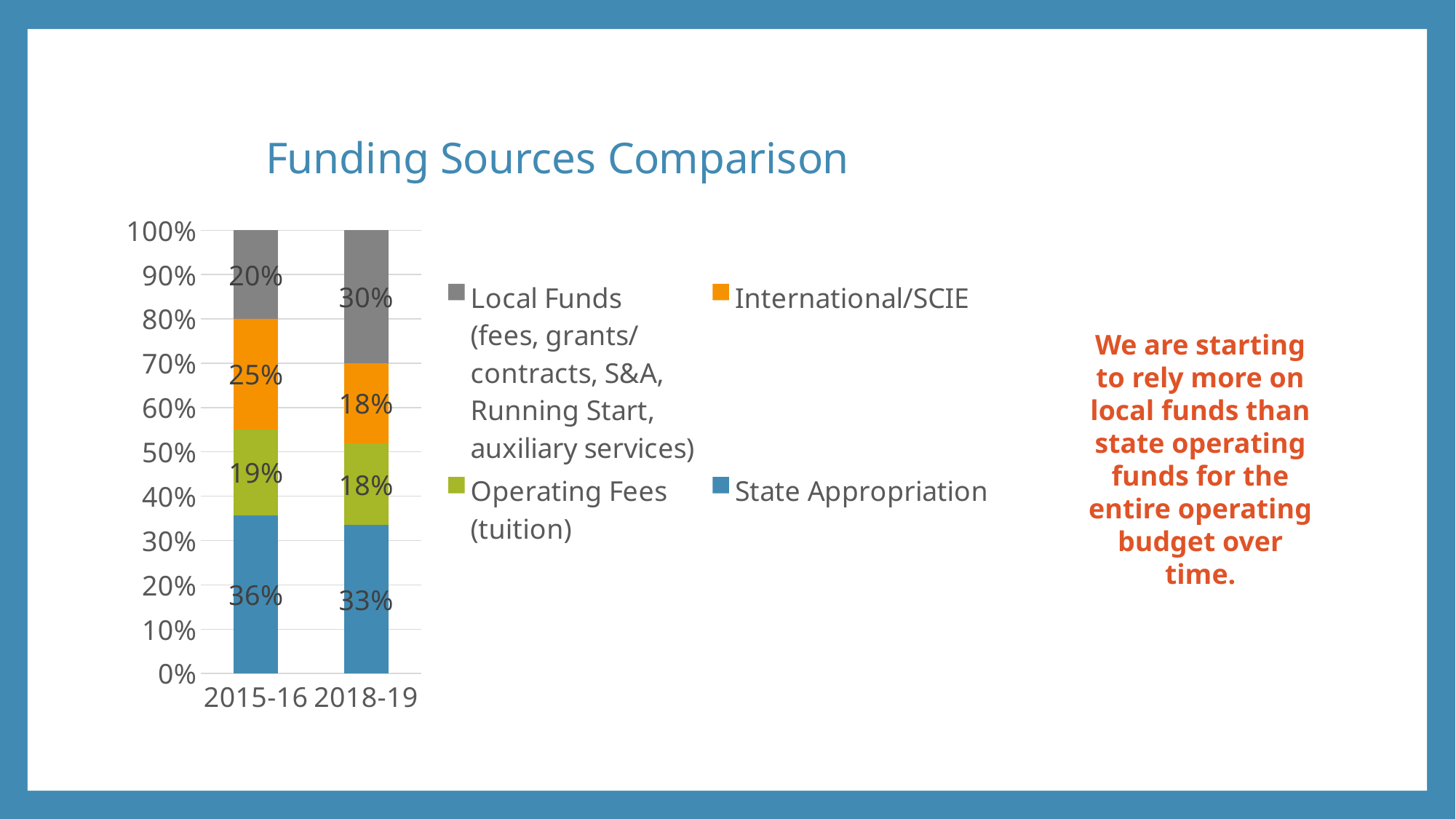
Which funding source has the smallest share in 2018-19? Operating Fees (tuition) and International/SCIE (both 18%) By how many percentage points did the Local Funds share change from 2015-16 to 2018-19? 10 percentage points What is the Local Funds share for 2018-19? 30% What is the International/SCIE share for 2015-16? 25% What kind of chart is shown? Stacked bar chart How many series does the legend list? 4 What is the State Appropriation share for 2015-16? 36% What is the title of the chart? Funding Sources Comparison Is the State Appropriation share larger in 2015-16 or 2018-19? 2015-16 How many years are compared in the chart? 2 Which funding source has the largest share in 2015-16? State Appropriation What is the Operating Fees (tuition) share for 2018-19? 18%